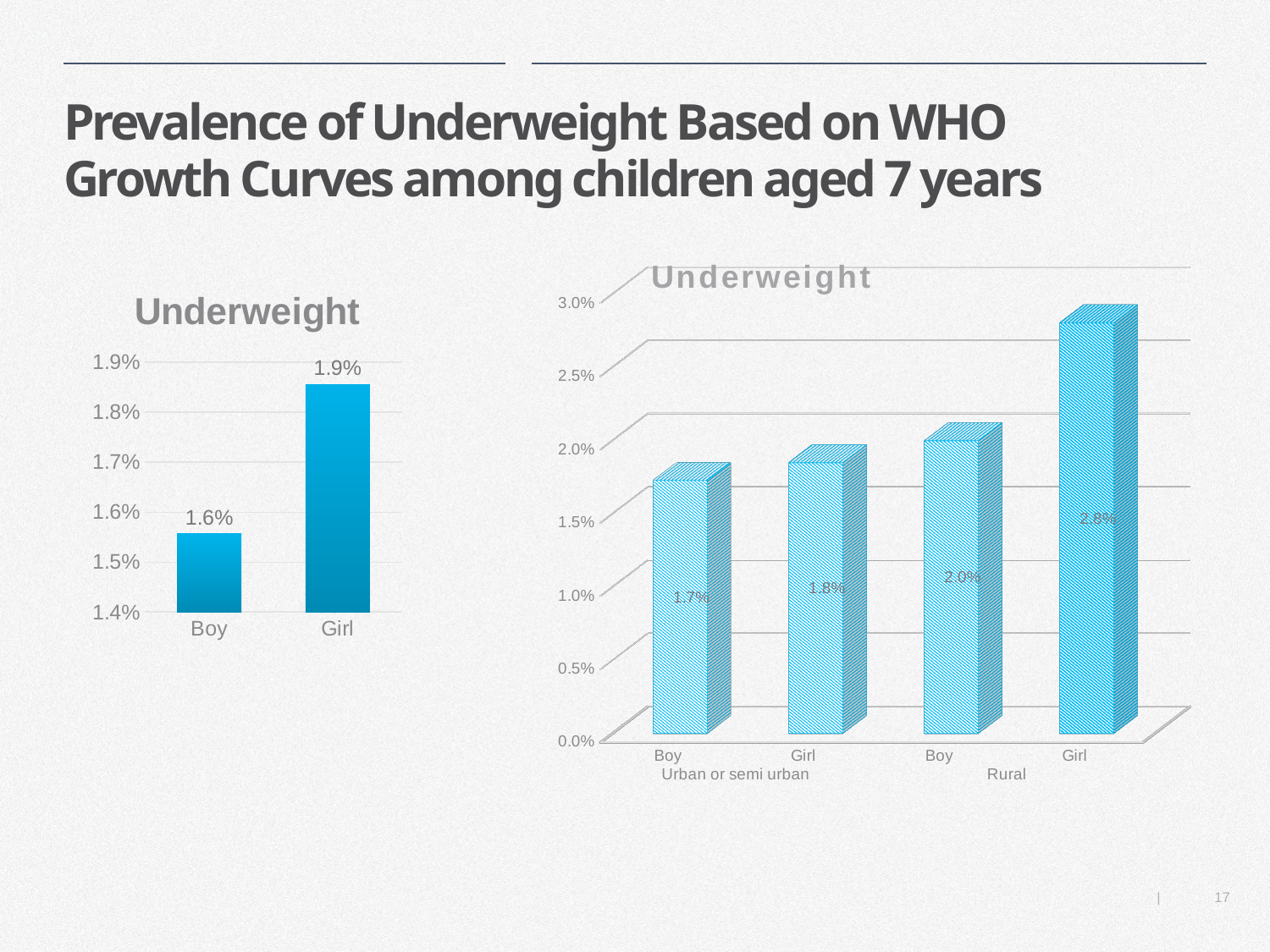
In the left chart, what is the underweight prevalence for Boy? 1.6% In the right chart, what is the value for Boy in the Rural group? 2.0% In the right chart, which bar has the highest value? Rural Girl In the right chart, what is the value for Boy in the Urban or semi urban group? 1.7% In the right chart, what is the difference between the Rural Girl and Rural Boy values? 0.8% In the right chart, which bar has the lowest value? Urban or semi urban Boy In the left chart, what is the underweight prevalence for Girl? 1.9% In the left chart, what is the difference between the Girl and Boy values? 0.3% In the left chart, which category has the higher value, Boy or Girl? Girl In the right chart, what is the value for Girl in the Rural group? 2.8% What type of chart is the right chart? Bar chart In the left chart, how many bars are plotted? 2